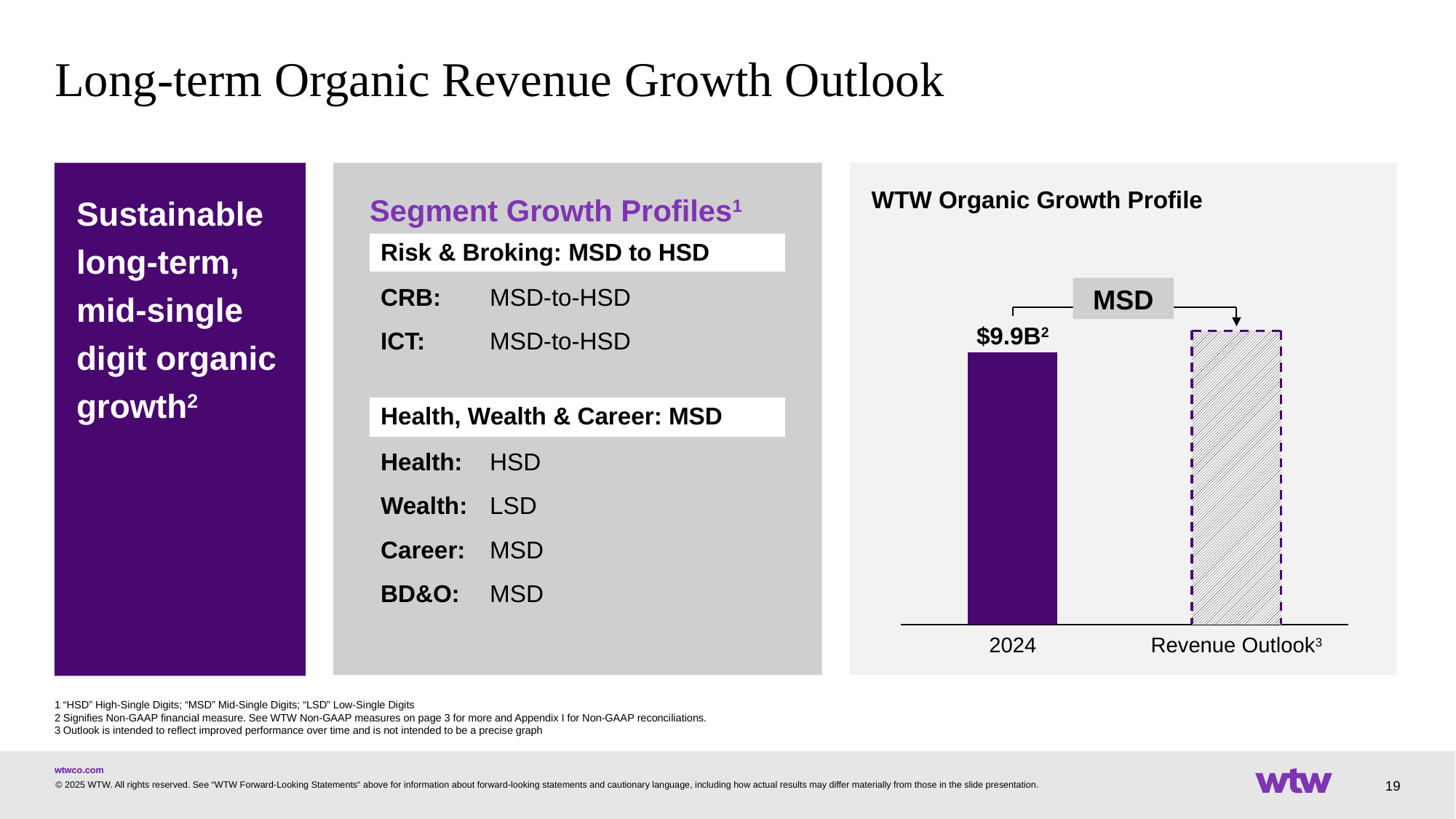
What growth label is shown on the arrow between the 2024 bar and the Revenue Outlook bar? MSD What is the value shown for the 2024 bar in the WTW Organic Growth Profile chart? $9.9B Which bar is taller in the WTW Organic Growth Profile chart, 2024 or Revenue Outlook? Revenue Outlook How many bars are plotted in the WTW Organic Growth Profile chart? 2 What are the two category labels on the x axis of the WTW Organic Growth Profile chart? 2024 and Revenue Outlook Do the bars in the WTW Organic Growth Profile chart rise or fall from 2024 to Revenue Outlook? Rise What kind of chart is the WTW Organic Growth Profile? Bar chart What is the title of the chart on the right side of the slide? WTW Organic Growth Profile